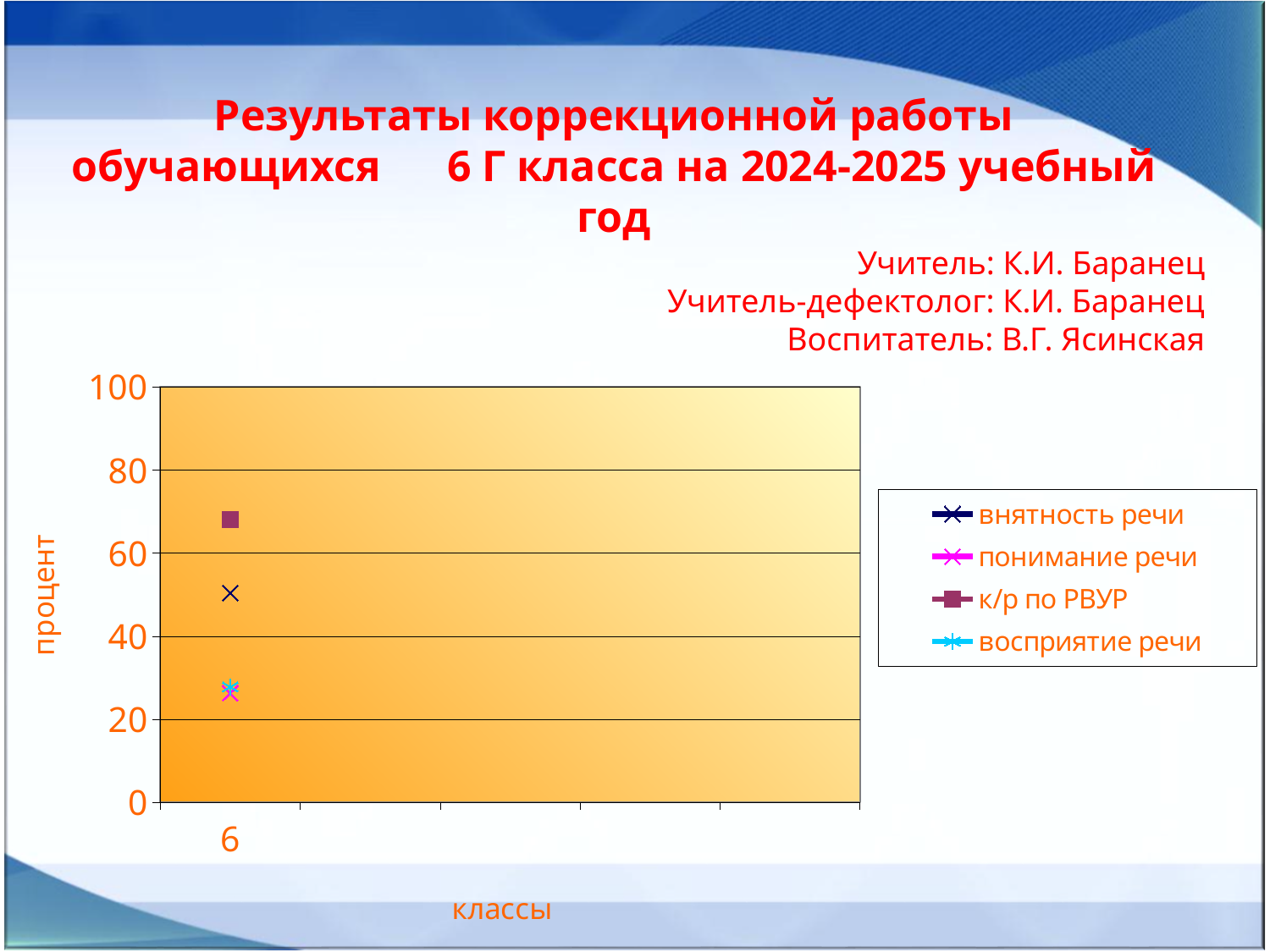
Is the value for внятность речи greater or less than 40? greater What is the label of the horizontal axis? классы How many categories are shown on the x axis? 1 What is the label of the vertical axis? процент Is the value for к/р по РВУР greater or less than 60? greater Which series has the highest value for class 6? к/р по РВУР Which is larger, the value for внятность речи or the value for к/р по РВУР? к/р по РВУР Is the value for внятность речи greater or less than 60? less How many series does the legend list? 4 Which is larger, the value for внятность речи or the value for понимание речи? внятность речи